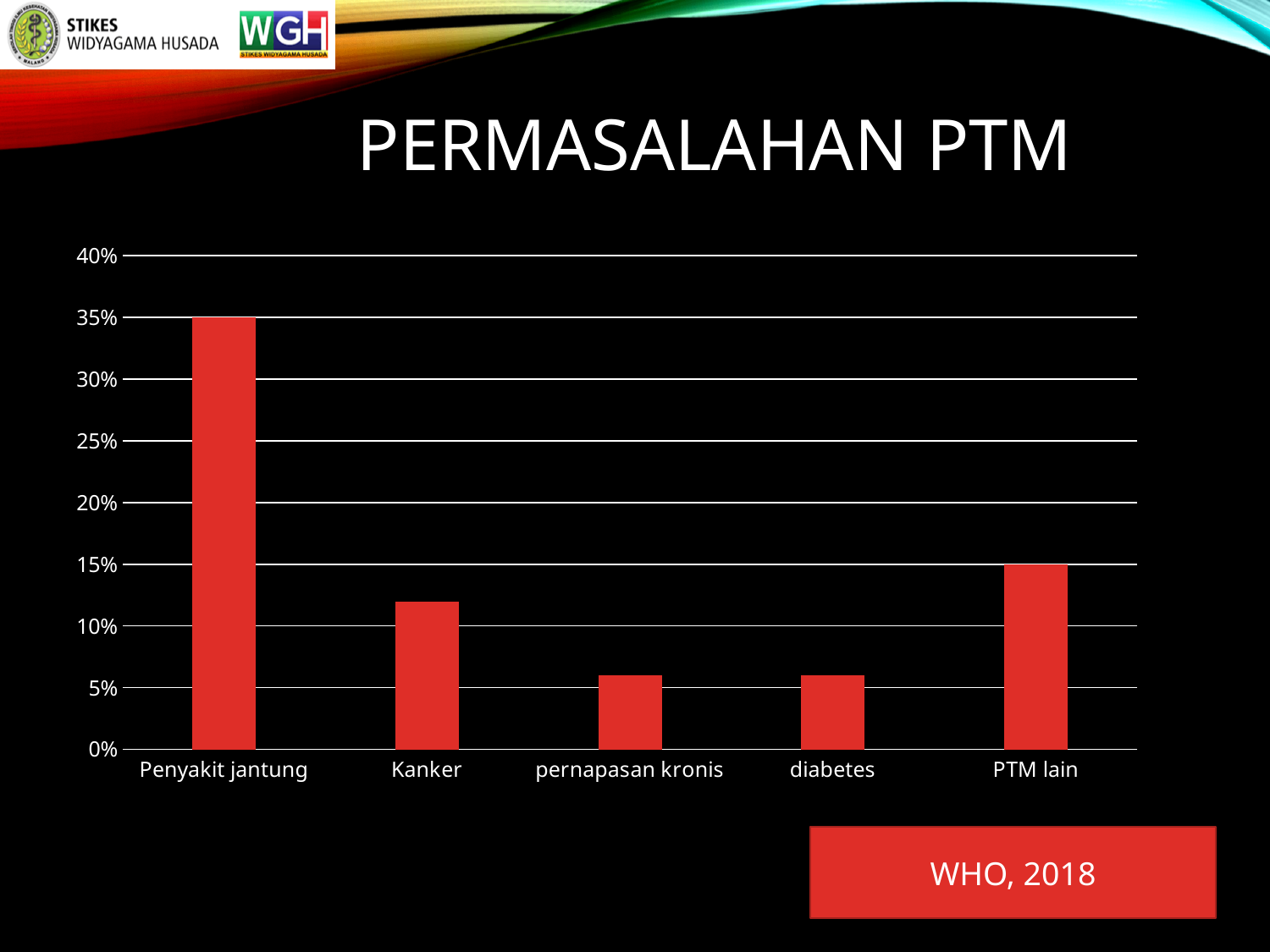
What is the value for Penyakit jantung? 35% What is the difference between the values for Penyakit jantung and PTM lain? 20% Is the value for Kanker greater or less than 10%? greater What is the value for PTM lain? 15% Which is larger, the value for Kanker or the value for PTM lain? PTM lain What kind of chart is shown on the slide? bar chart What is the title of the slide containing the chart? PERMASALAHAN PTM Is the value for pernapasan kronis greater or less than 5%? greater Which category has the highest value in the chart? Penyakit jantung Is the value for diabetes greater or less than 10%? less How many categories are shown on the x axis of the chart? 5